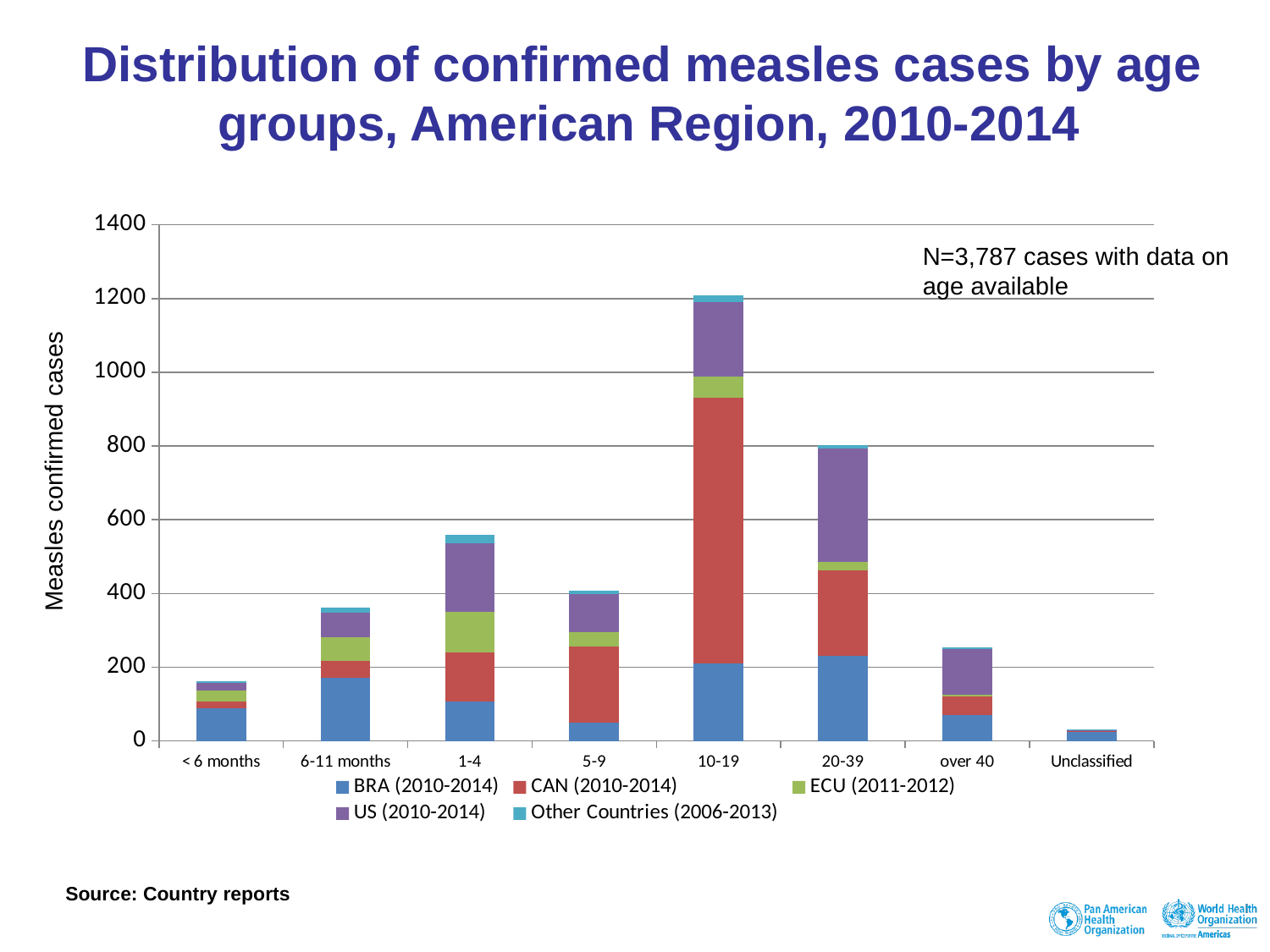
Is the total value for the < 6 months age group greater or less than 200? less According to the note on the chart, how many cases had data on age available? N=3,787 Is the total value for the over 40 age group greater or less than 200? greater What kind of chart is shown on the slide? Stacked bar chart Is the total value for the 20-39 age group greater or less than 1000? less How many series does the legend list? 5 Which age group has the lowest total number of measles confirmed cases? Unclassified Which has a larger total of confirmed cases, the 20-39 age group or the over 40 age group? 20-39 How many age group categories are shown on the x axis? 8 Which age group has the highest total number of measles confirmed cases? 10-19 Which has a larger total of confirmed cases, the 1-4 age group or the 5-9 age group? 1-4